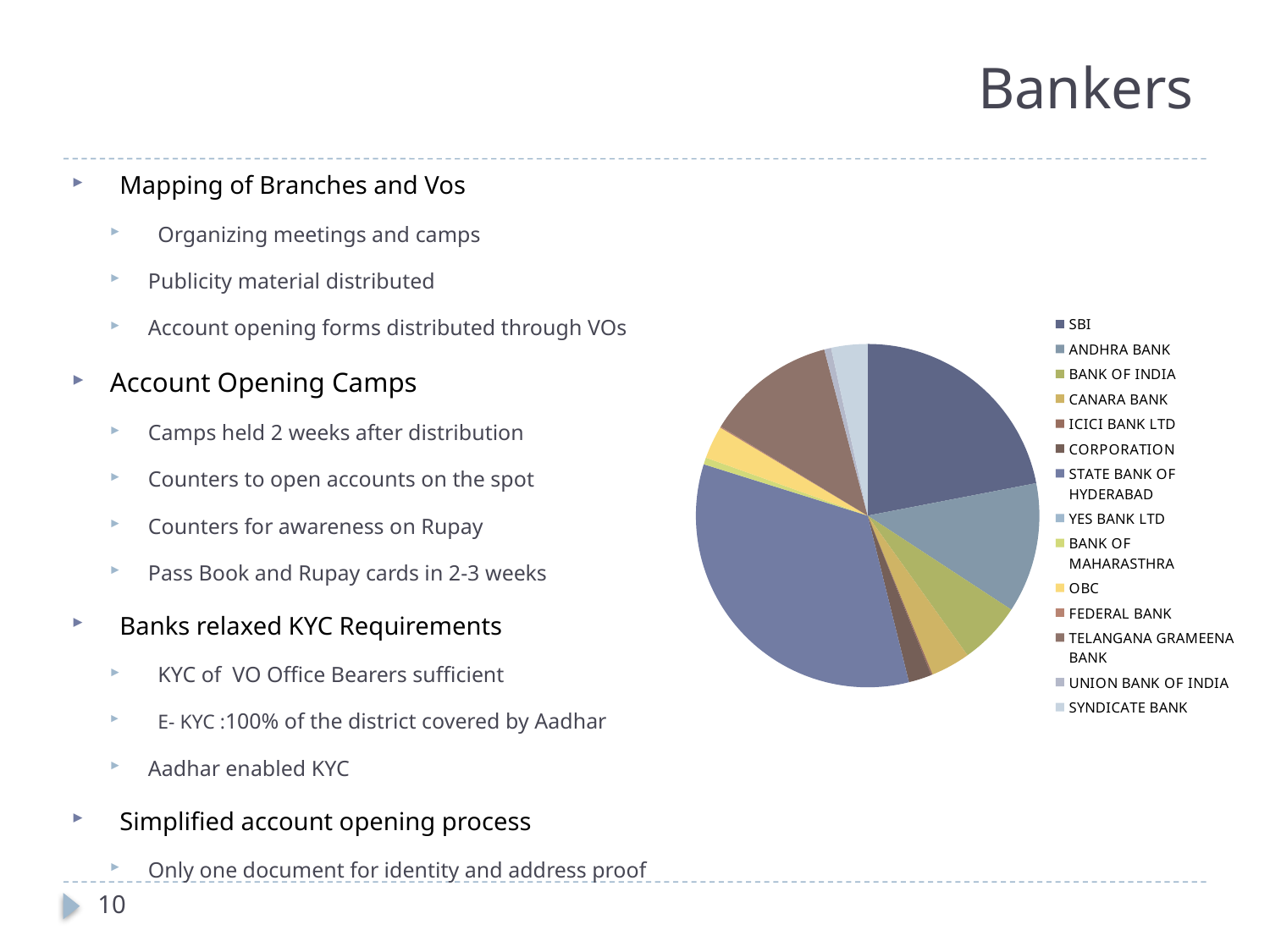
Which slice is larger in the pie chart, ANDHRA BANK or BANK OF INDIA? ANDHRA BANK How many entries does the legend of the pie chart list? 14 What kind of chart is shown on the slide? Pie chart Which bank is listed first in the pie chart's legend? SBI Which bank is listed last in the pie chart's legend? SYNDICATE BANK Which slice is larger in the pie chart, STATE BANK OF HYDERABAD or SBI? STATE BANK OF HYDERABAD Which slice is larger in the pie chart, TELANGANA GRAMEENA BANK or CANARA BANK? TELANGANA GRAMEENA BANK Which bank has the largest slice of the pie chart? STATE BANK OF HYDERABAD